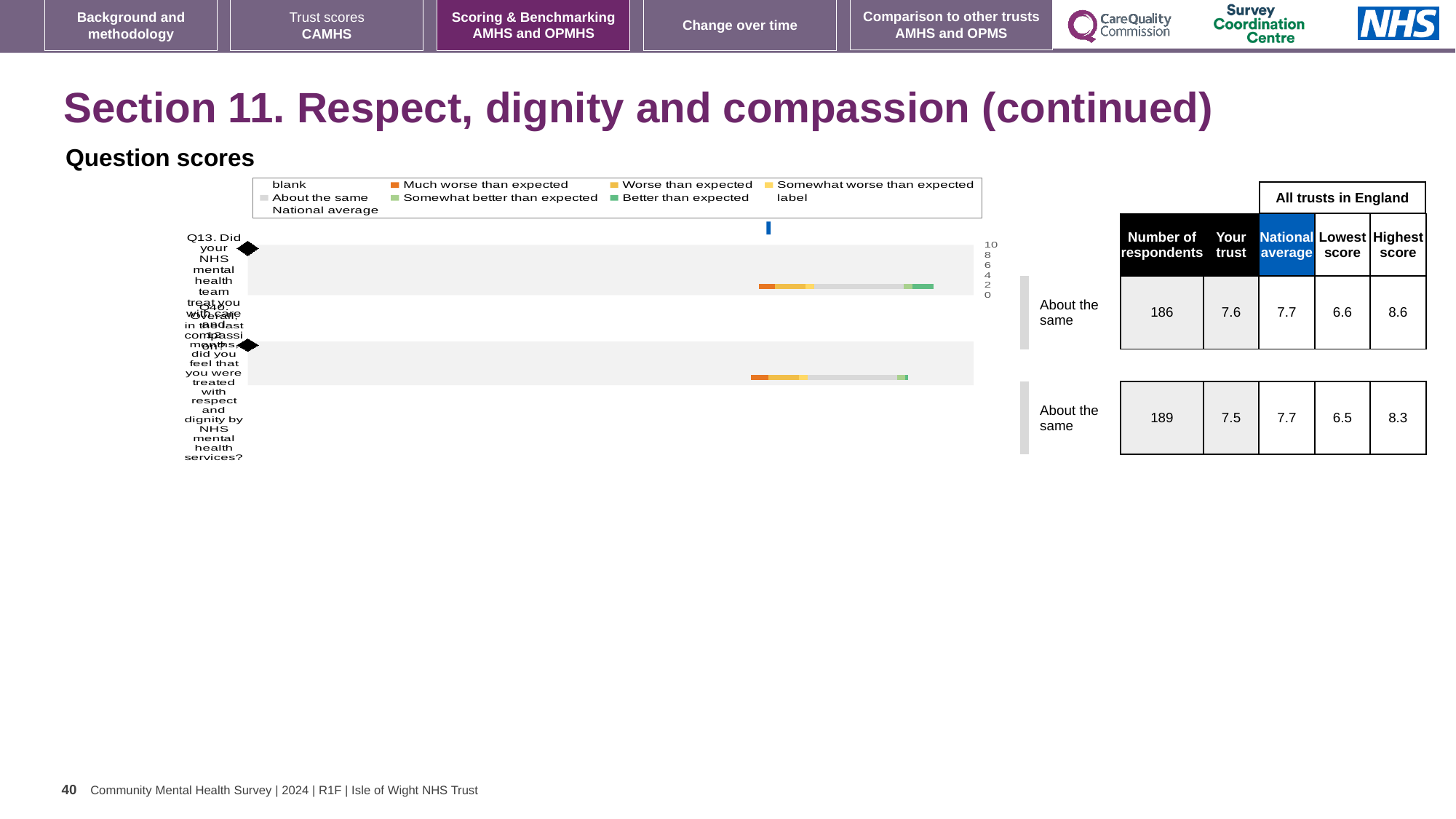
How many questions are plotted in the question scores chart? 2 What is the national average score for Q13? 7.7 Which question had more respondents, Q13 or Q10? Q10 What kind of chart is used to show the question scores on this slide? bar chart How many respondents answered Q10? 189 What benchmark category is shown for Q13? About the same What is the 'Your trust' score for Q13 (care and compassion)? 7.6 What is the 'Your trust' score for Q10 (respect and dignity)? 7.5 For Q13, which is larger: the 'Your trust' score or the national average? National average What is the difference between the highest score and the lowest score for Q13? 2.0 What benchmark category is shown for Q10? About the same What is the difference between the highest score and the lowest score for Q10? 1.8